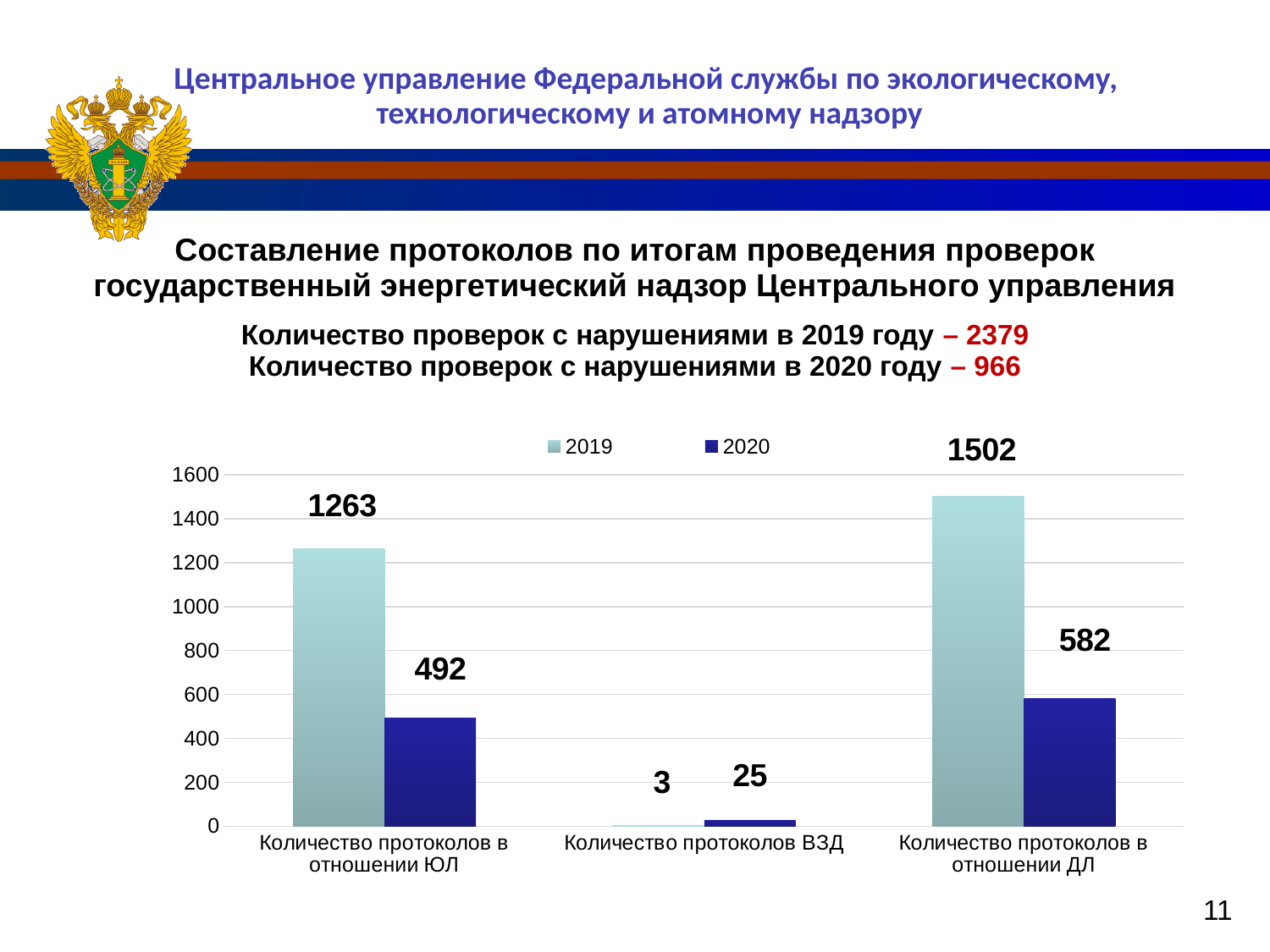
What is the 2020 value for «Количество протоколов ВЗД»? 25 What is the 2020 value for «Количество протоколов в отношении ДЛ»? 582 What is the 2019 value for «Количество протоколов в отношении ЮЛ»? 1263 What kind of chart is shown on the slide? bar chart For «Количество протоколов ВЗД», which year has the larger value, 2019 or 2020? 2020 Is the 2020 value for «Количество протоколов в отношении ЮЛ» greater or less than 600? less Which category has the lowest 2020 value? Количество протоколов ВЗД Which series is shown in dark blue? 2020 How many categories are shown on the x axis? 3 What is the difference between the 2019 and 2020 values for «Количество протоколов в отношении ЮЛ»? 771 How many series does the legend list? 2 Which category has the highest 2019 value? Количество протоколов в отношении ДЛ